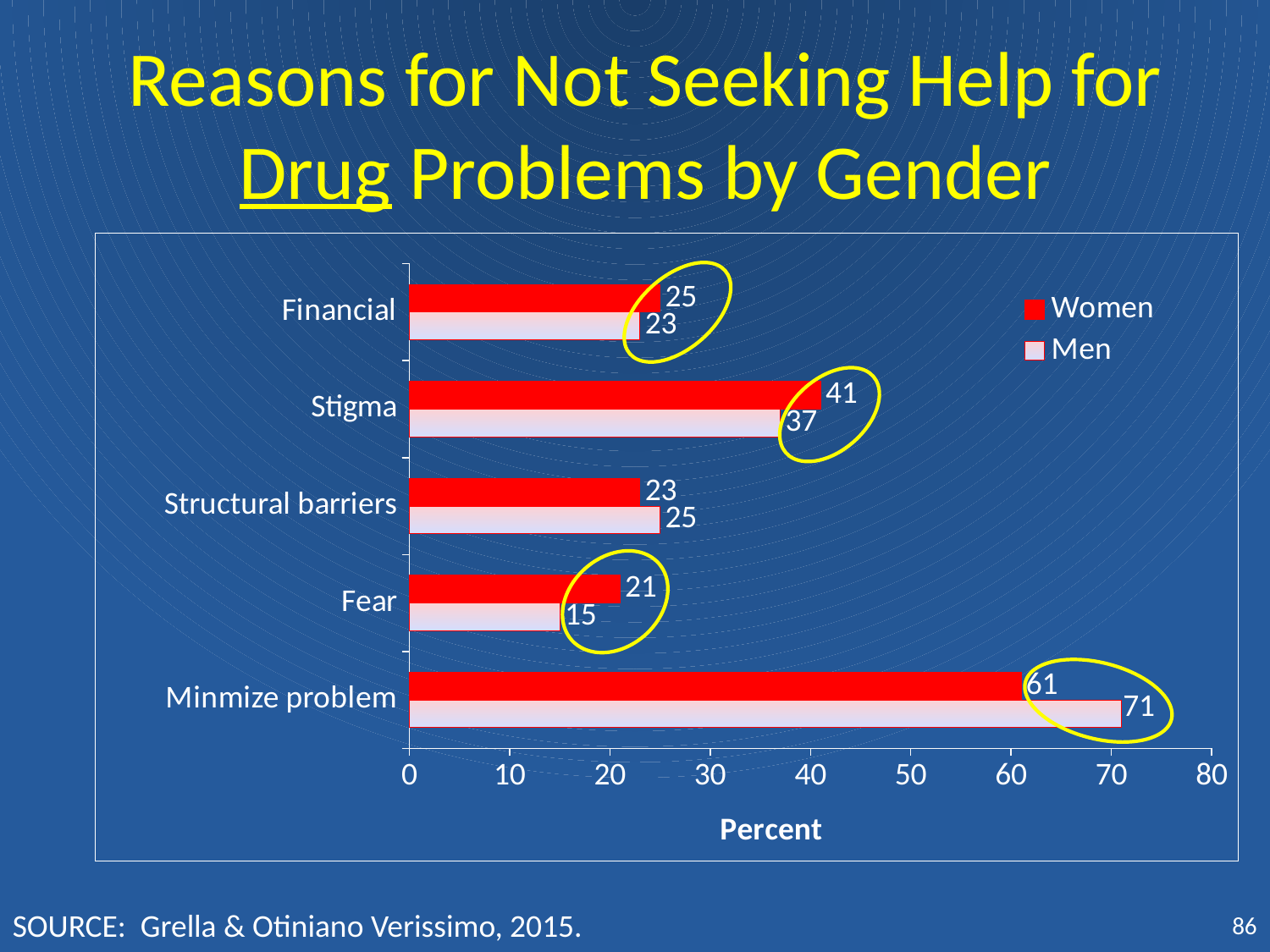
Which category has the highest value for Women? Minmize problem What kind of chart is shown on the slide? bar chart Which category has the lowest value for Men? Fear What is the label of the horizontal axis? Percent What is the value for Men for Minmize problem? 71 Which is larger for Stigma, the Women value or the Men value? Women What is the value for Men for Fear? 15 What is the value for Women for Stigma? 41 How many categories are shown on the chart? 5 What is the difference between the Men and Women values for Minmize problem? 10 Is the value for Men for Stigma greater or less than 30? greater How many series does the legend list? 2